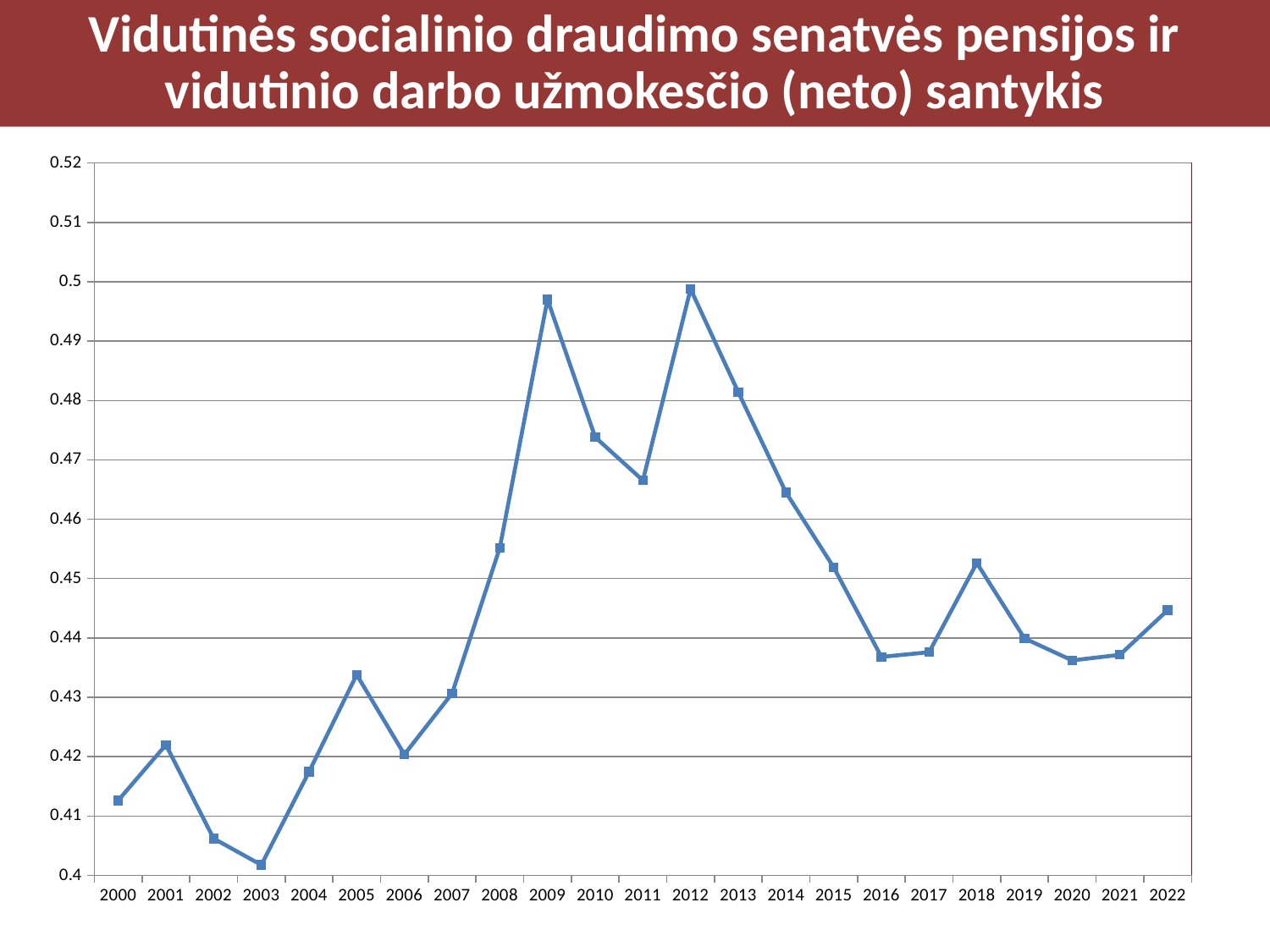
Which year has the lowest value? 2003 Is the value for 2009 greater or less than 0.49? greater Is the value for 2011 greater or less than 0.47? less Is the value for 2016 greater or less than 0.44? less What is the title of the chart? Vidutinės socialinio draudimo senatvės pensijos ir vidutinio darbo užmokesčio (neto) santykis What kind of chart is shown on the slide? line chart Do the values rise or fall from 2012 to 2016? fall How many years are plotted on the x axis? 23 Which is larger, the value for 2005 or the value for 2006? 2005 Which is larger, the value for 2012 or the value for 2015? 2012